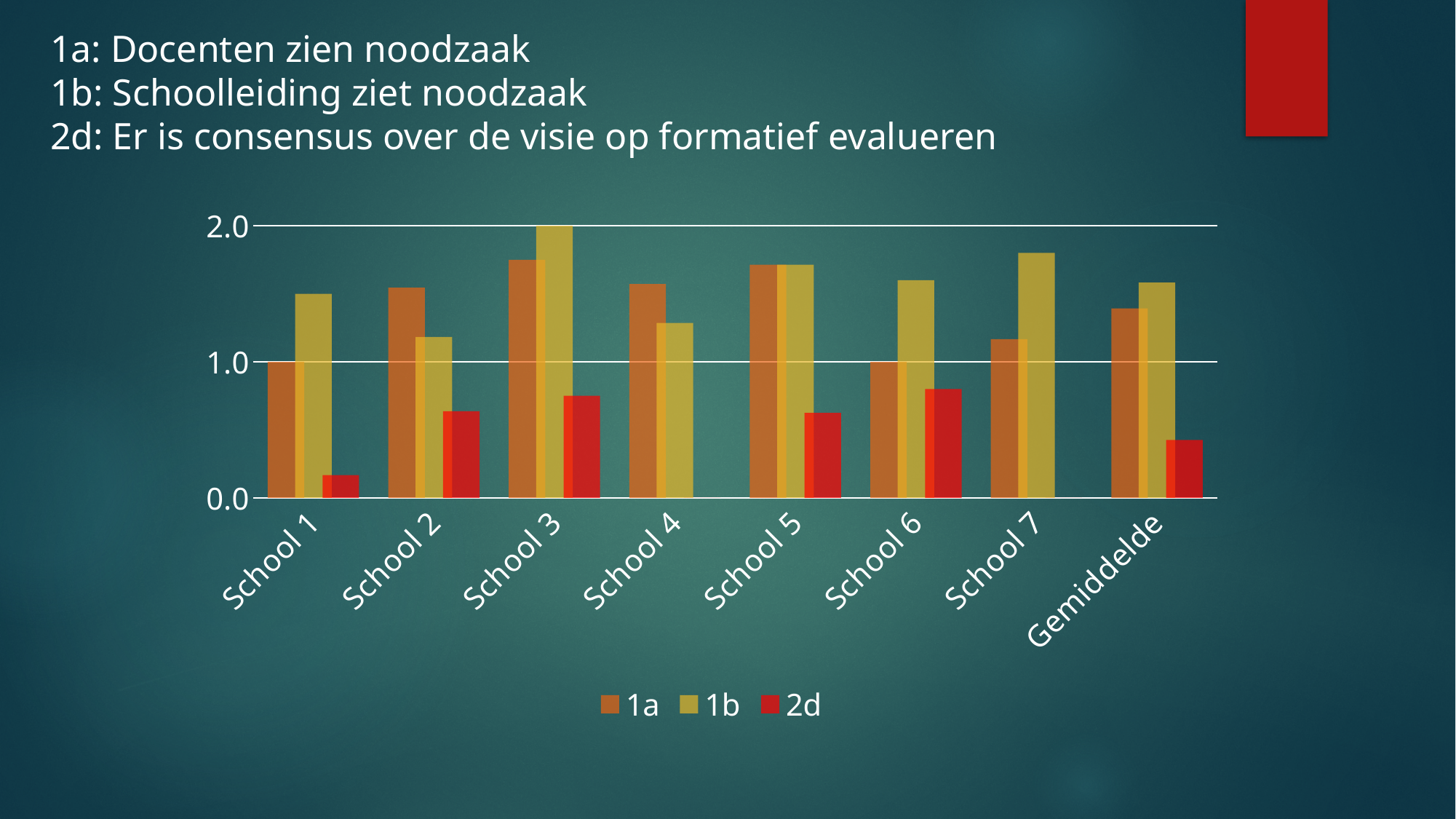
What is the value of series 1b for School 3? 2.0 Is the value of series 2d for School 1 greater or less than 1.0? less What is the value of series 1a for School 6? 1.0 Is the value of series 1b for School 7 greater or less than 1.0? greater What is the value of series 1a for School 1? 1.0 How many categories are shown on the x axis? 8 Which school has the highest value for series 1b? School 3 According to the slide text, what does 1a stand for? Docenten zien noodzaak What kind of chart is shown on the slide? bar chart How many series does the legend list? 3 For School 7, which series has the larger value, 1a or 1b? 1b Which is larger: the 1b value for School 3 or the 1b value for School 4? School 3